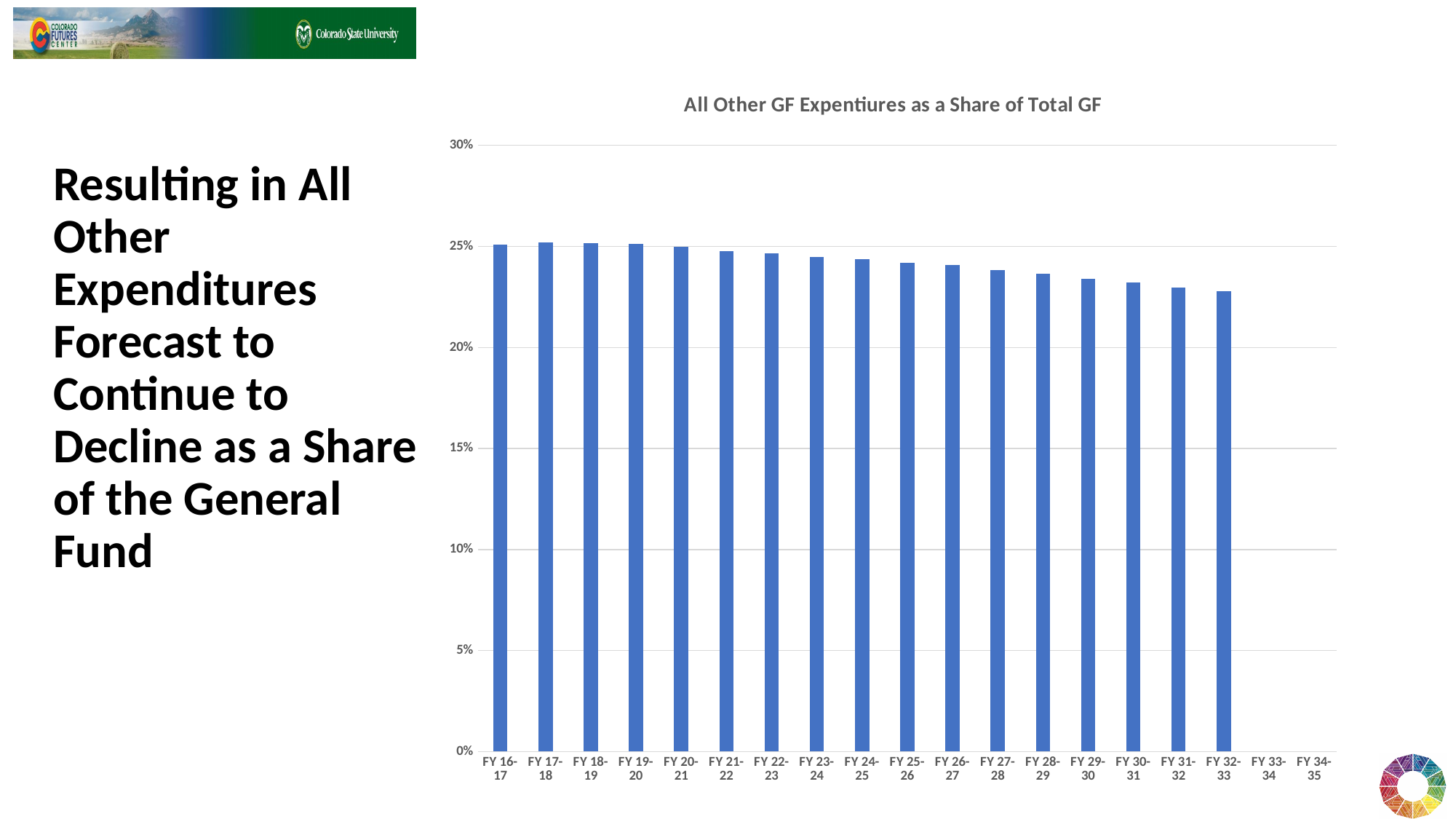
Which is larger, the value for FY 20-21 or the value for FY 30-31? FY 20-21 How many bars are plotted in the chart? 17 What is the title of the chart? All Other GF Expentiures as a Share of Total GF Which is larger, the value for FY 16-17 or the value for FY 32-33? FY 16-17 What kind of chart is shown on the slide? Bar chart Do the values generally rise or fall from FY 16-17 to FY 32-33? Fall Which fiscal year has the lowest bar in the chart? FY 32-33 What is the highest value shown on the vertical axis? 30% Is the value for FY 32-33 greater or less than 25%? less Is the value for FY 16-17 greater or less than 20%? greater Is the value for FY 30-31 greater or less than 20%? greater